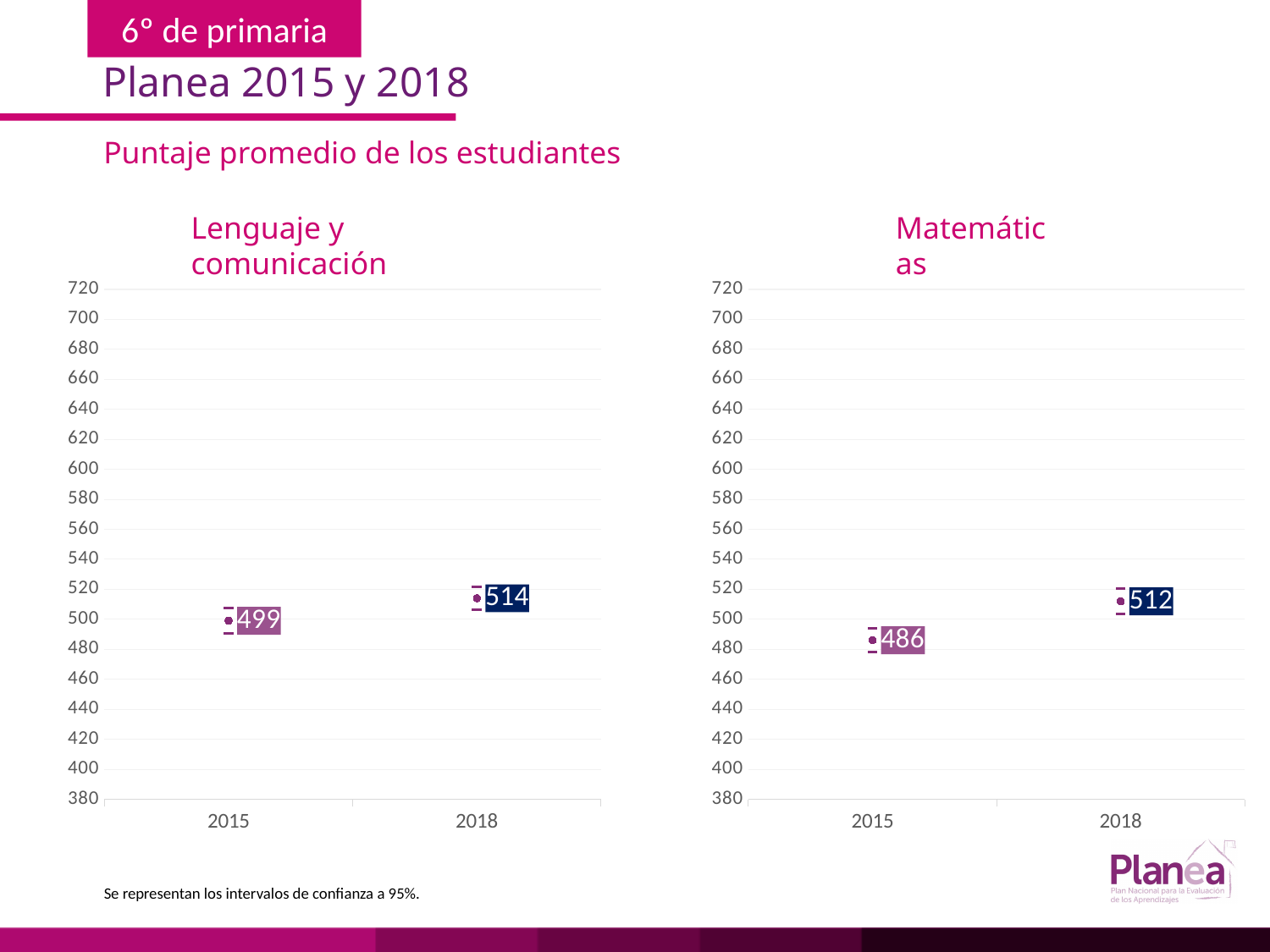
In the 'Lenguaje y comunicación' chart, what is the value for 2018? 514 In the 'Matemáticas' chart, what is the difference between the 2018 and 2015 values? 26 In the 'Matemáticas' chart, which year has the higher value, 2015 or 2018? 2018 In the 'Lenguaje y comunicación' chart, what is the difference between the 2018 and 2015 values? 15 How many years are plotted on the x axis of the 'Lenguaje y comunicación' chart? 2 What is the subtitle shown above the two charts? Puntaje promedio de los estudiantes In the 'Matemáticas' chart, what is the value for 2018? 512 In the 'Lenguaje y comunicación' chart, which year has the lowest value? 2015 In the 'Matemáticas' chart, what is the value for 2015? 486 In the 'Matemáticas' chart, do the values rise or fall from 2015 to 2018? rise In the 'Matemáticas' chart, is the value for 2015 greater or less than 500? less In the 'Lenguaje y comunicación' chart, what is the value for 2015? 499